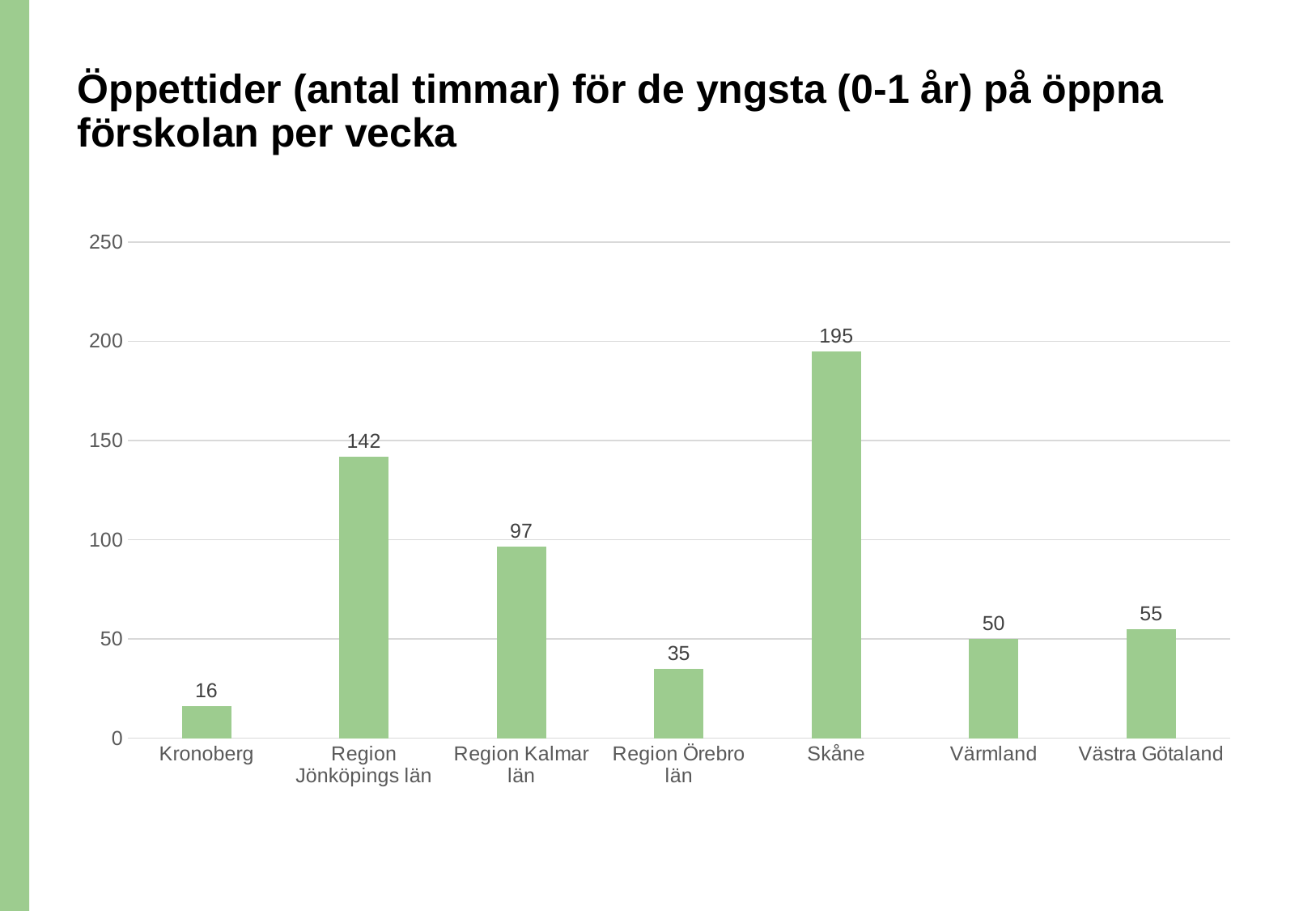
Which is larger, the value for Värmland or the value for Västra Götaland? Västra Götaland What is the value for Skåne? 195 What is the value for Region Örebro län? 35 Which category has the lowest value? Kronoberg What is the difference between the values for Skåne and Region Jönköpings län? 53 What kind of chart is shown on the slide? bar chart How many categories are shown on the x axis? 7 What is the value for Region Jönköpings län? 142 What is the title of the chart? Öppettider (antal timmar) för de yngsta (0-1 år) på öppna förskolan per vecka Which category has the highest value? Skåne What is the value for Kronoberg? 16 Is the value for Region Kalmar län greater or less than 100? less